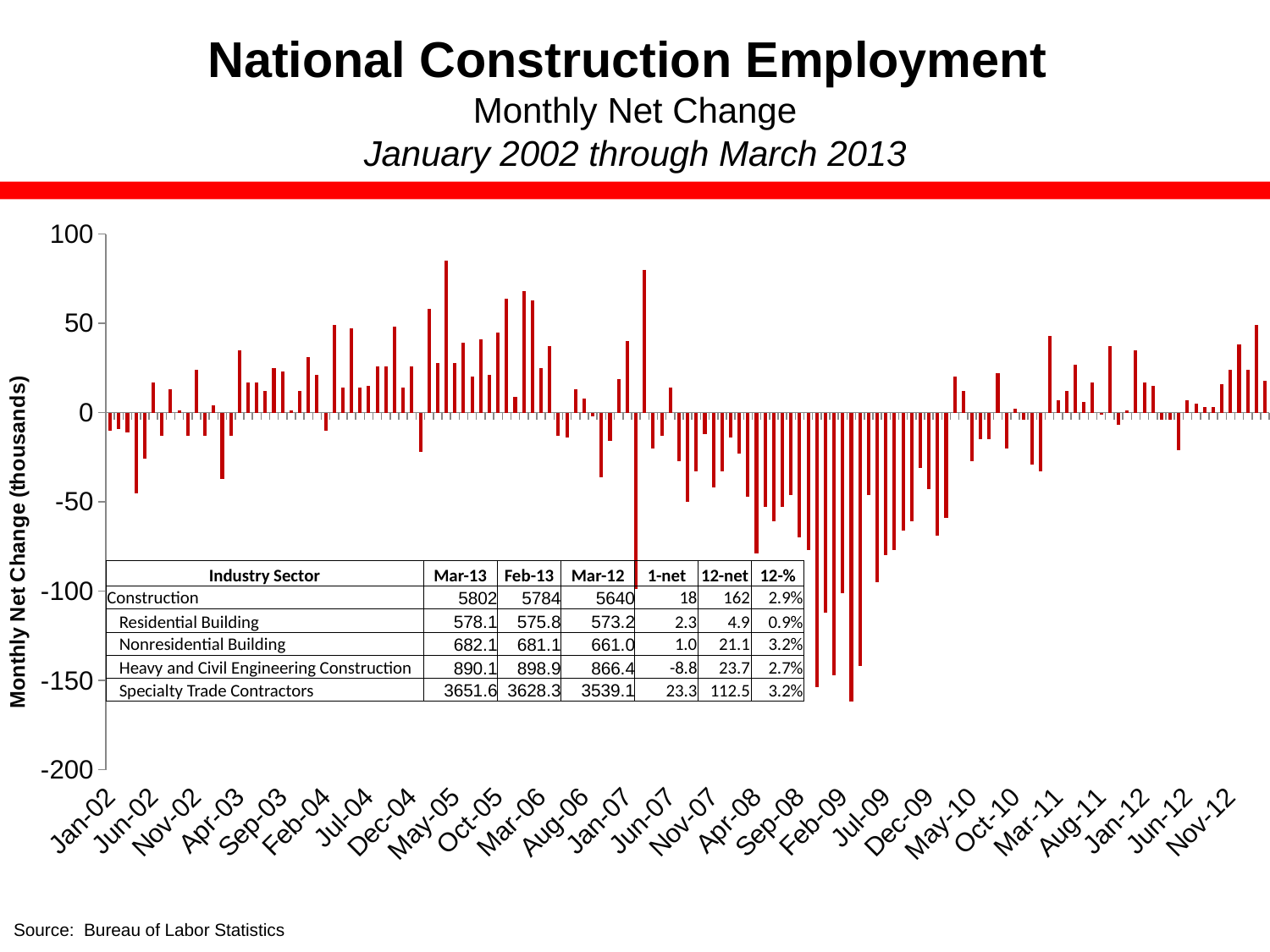
What kind of chart is shown on the slide? bar chart What is the lowest value shown on the vertical axis of the chart? -200 What is the label on the vertical axis of the chart? Monthly Net Change (thousands) Is the value for Sep-08 greater or less than -50? less In the table on the chart, what is the Mar-13 value for Construction? 5802 Is the value for Jan-02 greater or less than 0? less What is the highest value shown on the vertical axis of the chart? 100 How many month labels are shown along the x axis of the chart? 27 What is the title of the chart on the slide? National Construction Employment Do the monthly values generally rise or fall between Jan-07 and Feb-09? fall Is the value for Jul-09 greater or less than 0? less